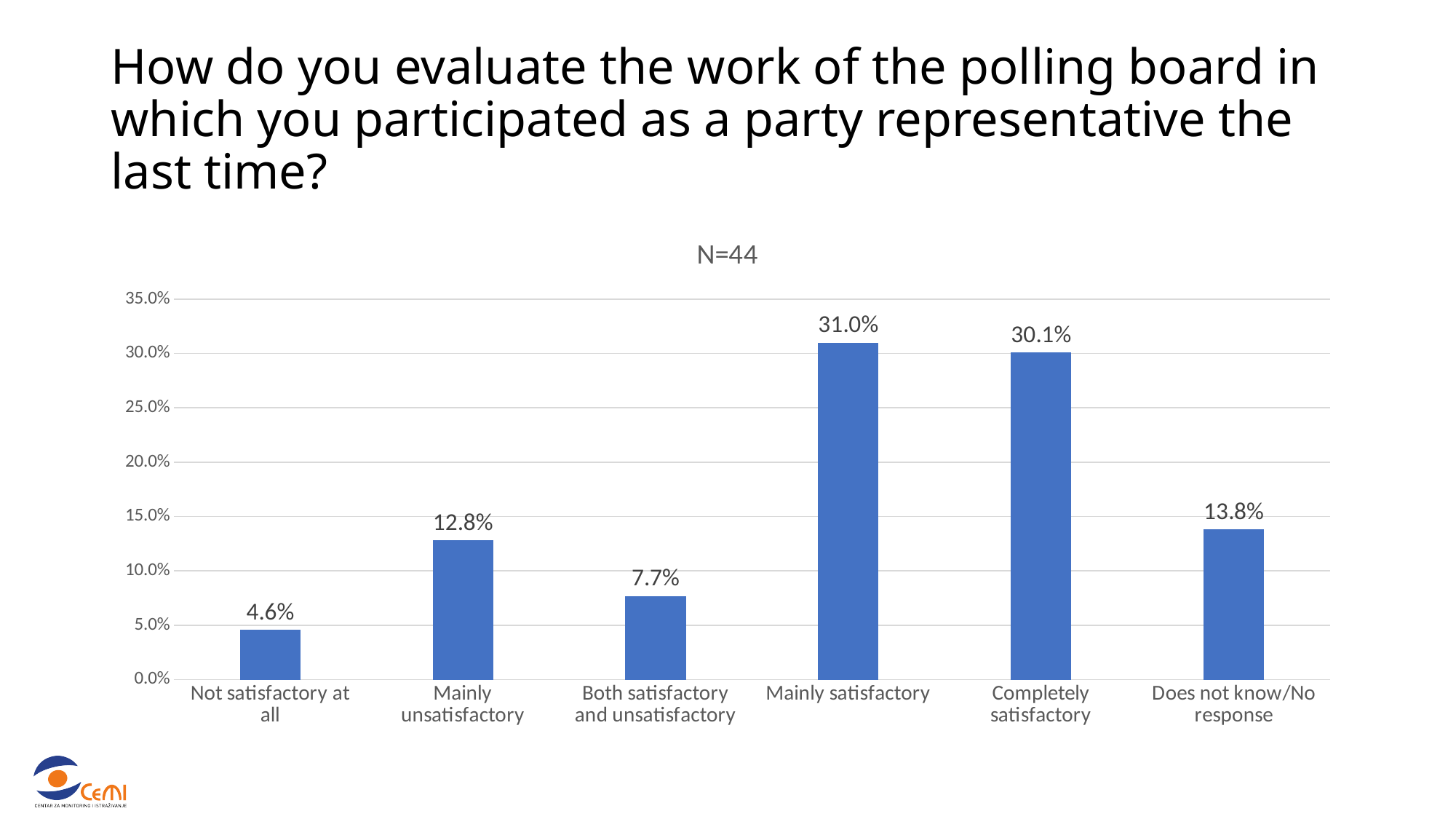
What kind of chart is shown on the slide? bar chart Which category has the highest value? Mainly satisfactory What is the value for "Both satisfactory and unsatisfactory"? 7.7% What is the value for "Mainly satisfactory"? 31.0% What is the title shown above the chart? N=44 What is the difference between the values for "Completely satisfactory" and "Mainly unsatisfactory"? 17.3% Which category has the lowest value? Not satisfactory at all Which is larger, the value for "Does not know/No response" or the value for "Mainly unsatisfactory"? Does not know/No response Is the value for "Completely satisfactory" greater or less than 25.0%? greater What is the value for "Does not know/No response"? 13.8% How many categories are shown on the x axis? 6 What is the value for "Not satisfactory at all"? 4.6%